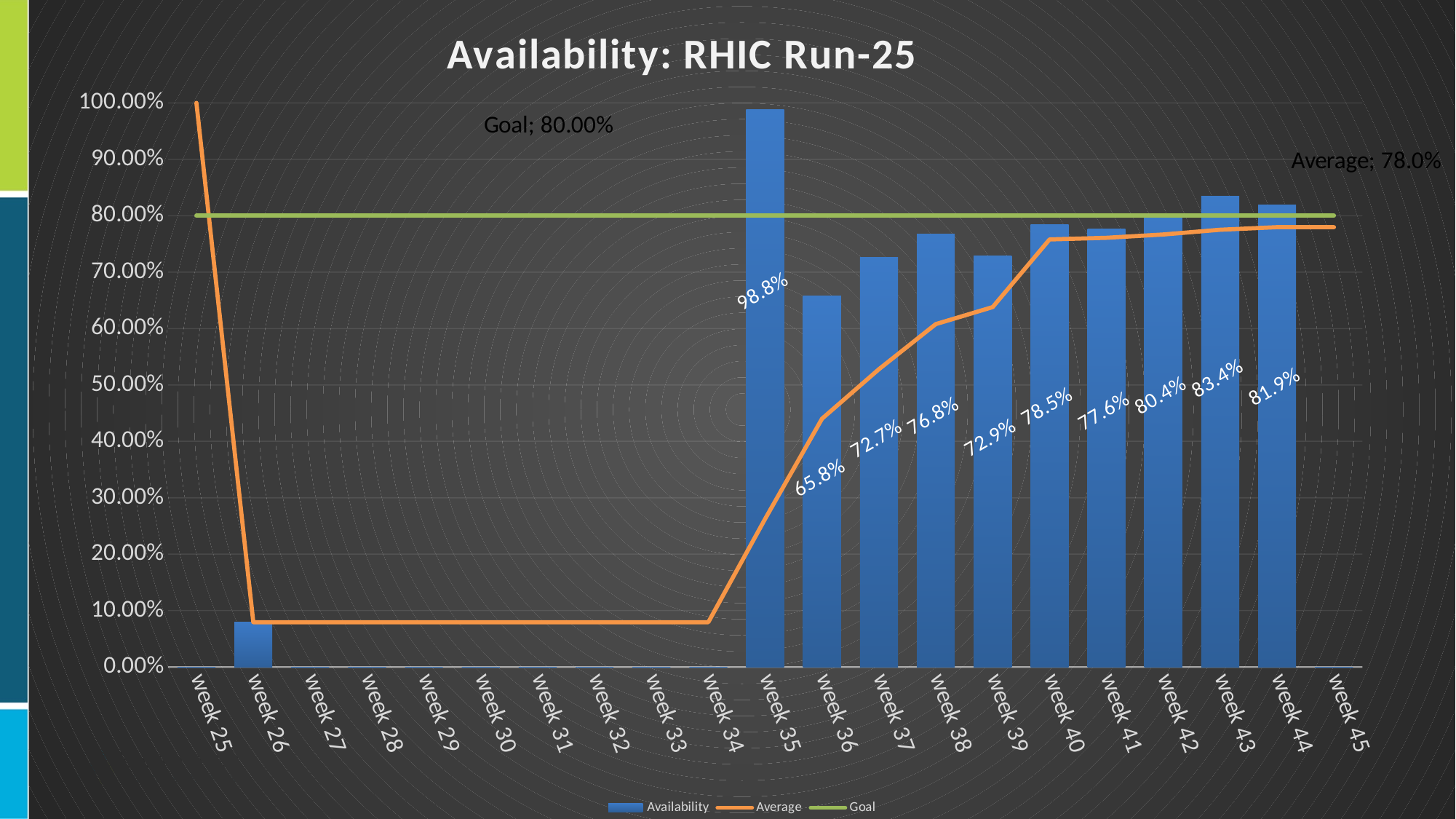
What is the Average value shown on the chart? 78.0% How many series does the legend list? 3 How many weeks are shown on the x axis? 21 What is the title of the chart? Availability: RHIC Run-25 Which week has the highest availability? week 35 What is the availability value for week 35? 98.8% What is the availability value for week 43? 83.4% Is the availability value for week 26 greater or less than 10.00%? less What is the difference between the availability for week 43 and week 36? 17.6 percentage points What is the availability value for week 36? 65.8% Which is larger, the availability for week 40 or week 41? week 40 What is the Goal value shown on the chart? 80.00%